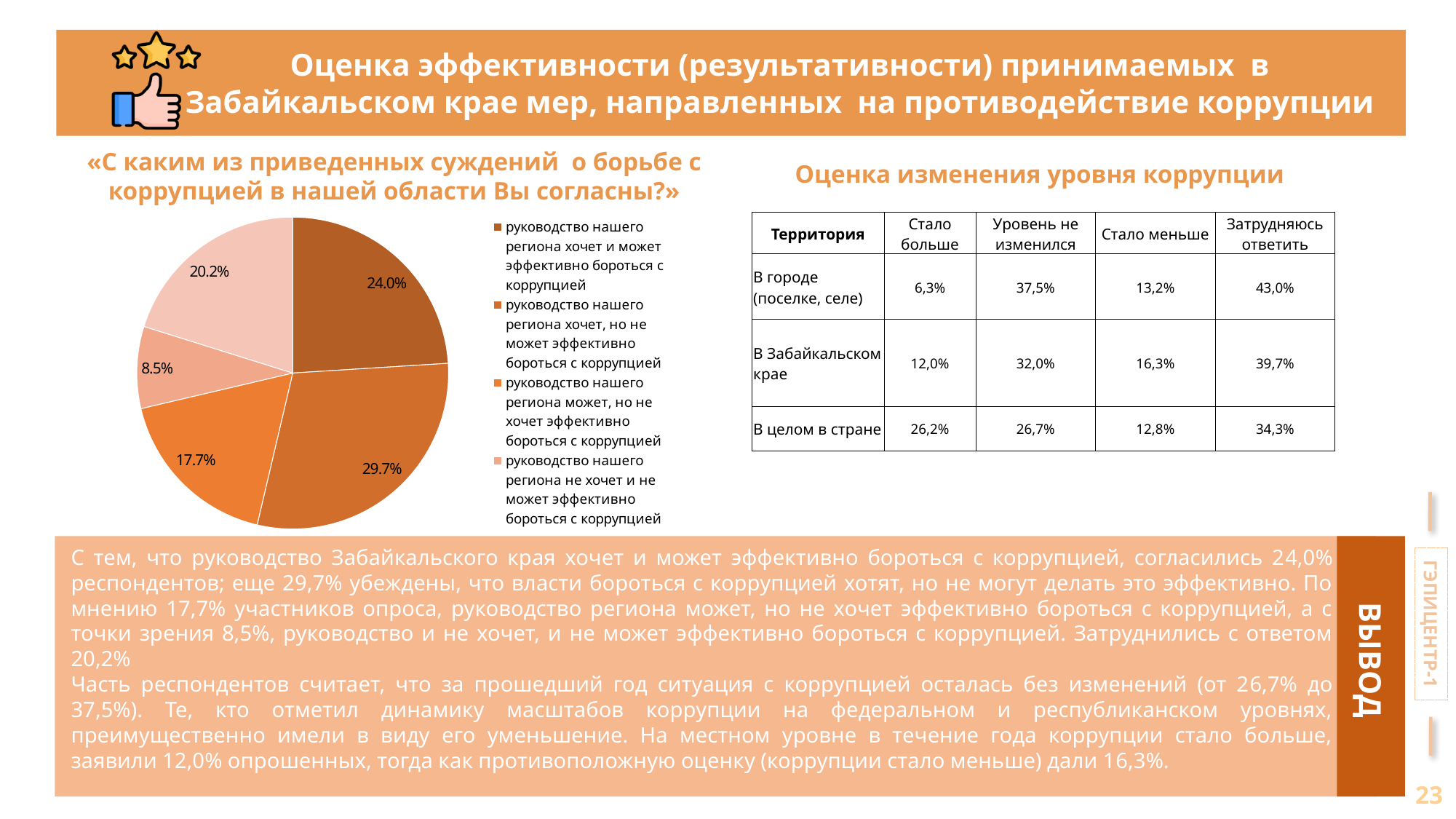
What is the title of the pie chart? «С каким из приведенных суждений о борьбе с коррупцией в нашей области Вы согласны?» How many slices does the pie chart have? 5 What kind of chart is shown on the left of the slide? pie chart In the pie chart, what is the difference between the 'хочет, но не может' slice and the 'хочет и может' slice? 5.7% Which slice of the pie chart is the smallest? 8.5% (руководство нашего региона не хочет и не может эффективно бороться с коррупцией) In the pie chart, what share of respondents agreed that the regional leadership wants and can effectively fight corruption (руководство нашего региона хочет и может эффективно бороться с коррупцией)? 24.0% Which slice of the pie chart is the largest? 29.7% (руководство нашего региона хочет, но не может эффективно бороться с коррупцией) In the pie chart, what share corresponds to 'руководство нашего региона может, но не хочет эффективно бороться с коррупцией'? 17.7% In the pie chart, what share corresponds to 'руководство нашего региона хочет, но не может эффективно бороться с коррупцией'? 29.7% In the pie chart, what share corresponds to 'руководство нашего региона не хочет и не может эффективно бороться с коррупцией'? 8.5% In the pie chart, which is larger: the 'может, но не хочет' slice or the 'не хочет и не может' slice? может, но не хочет (17.7%) How many entries are listed in the pie chart's legend? 4